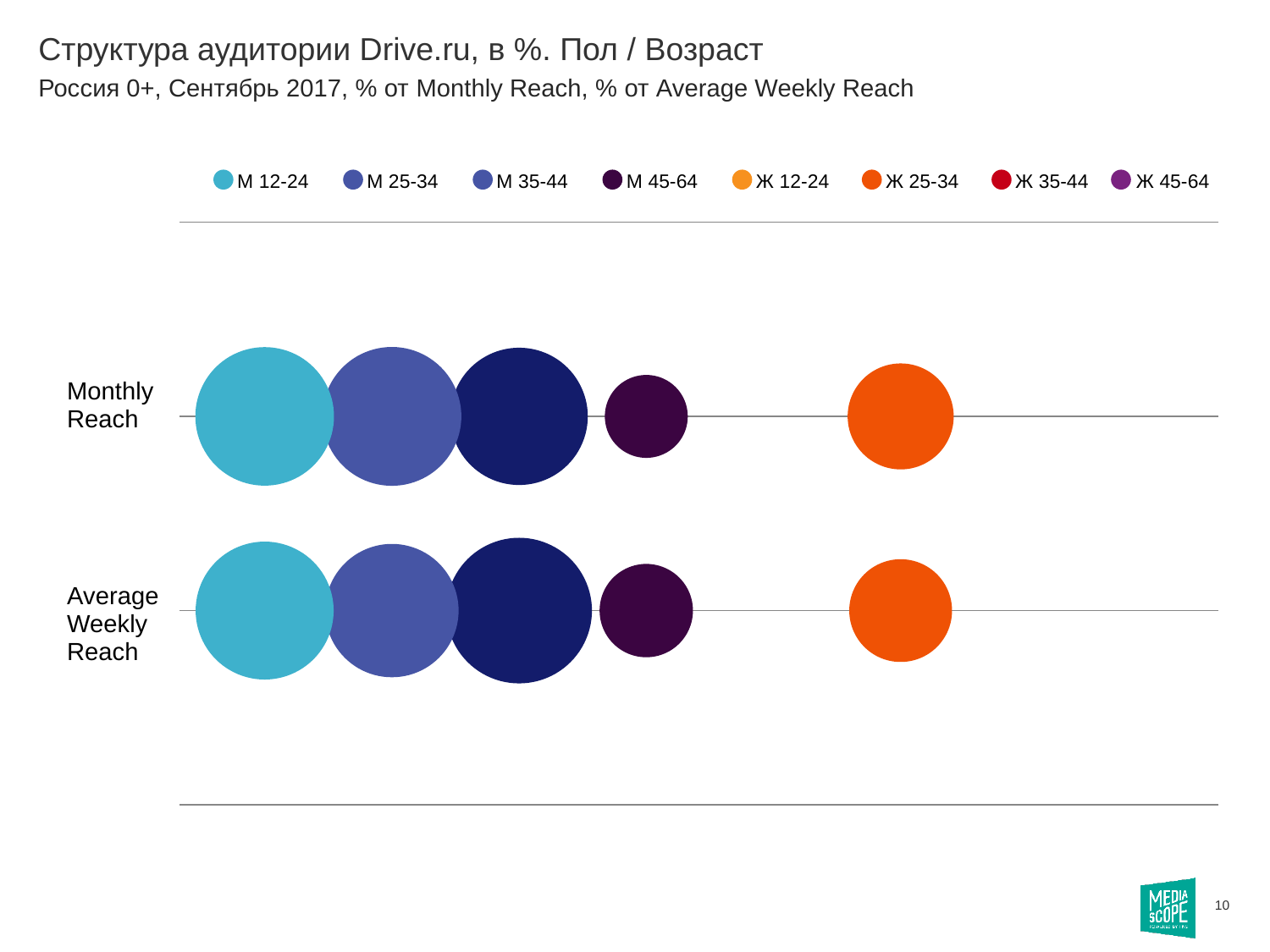
What kind of chart is shown on the slide? bubble chart What is the title of the chart on the slide? Структура аудитории Drive.ru, в %. Пол / Возраст How many series does the legend list? 8 In the Monthly Reach row, which of the visible bubbles is the smallest? М 45-64 In the Average Weekly Reach row, which bubble is larger: М 12-24 or М 45-64? М 12-24 What are the two categories shown on the y axis? Monthly Reach and Average Weekly Reach In the Monthly Reach row, which bubble is larger: Ж 25-34 or М 45-64? Ж 25-34 In the Average Weekly Reach row, which of the visible bubbles is the smallest? М 45-64 How many categories (rows) are plotted on the y axis? 2 In the Average Weekly Reach row, which bubble is larger: М 35-44 or Ж 25-34? М 35-44